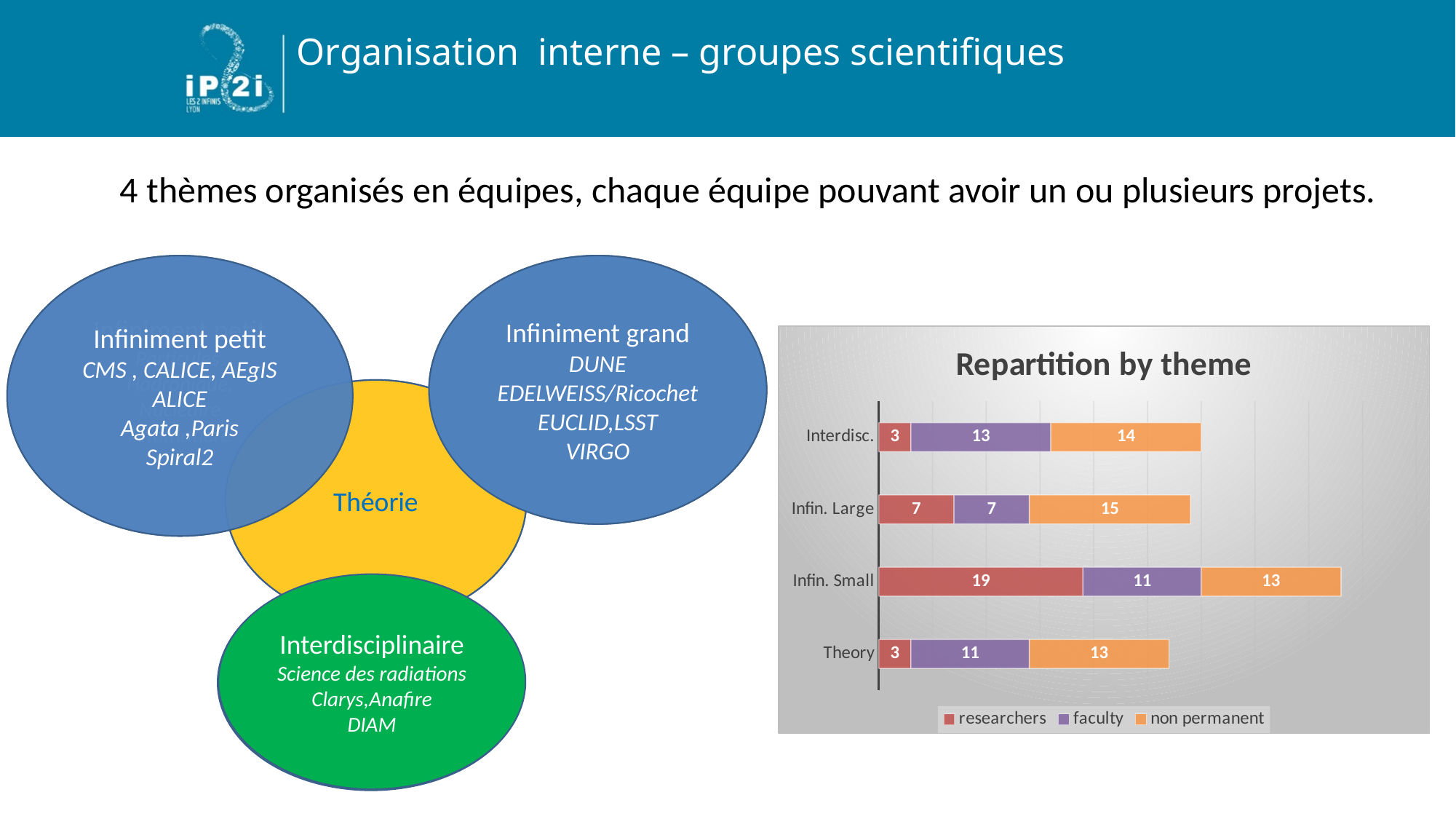
What type of chart is "Repartition by theme"? bar chart In "Repartition by theme", which theme has the lowest number of faculty? Infin. Large In "Repartition by theme", what is the total of the stacked bar for Infin. Small? 43 In "Repartition by theme", which theme has the highest number of researchers? Infin. Small In "Repartition by theme", what is the total of the stacked bar for Theory? 27 In "Repartition by theme", what is the number of non permanent for Infin. Large? 15 How many series does the legend of "Repartition by theme" list? 3 In "Repartition by theme", what is the faculty value for Theory? 11 In "Repartition by theme", what is the difference between the non permanent values for Infin. Large and Infin. Small? 2 How many themes are shown in "Repartition by theme"? 4 In "Repartition by theme", what is the number of researchers for Infin. Small? 19 In "Repartition by theme", which is larger: the faculty value for Interdisc. or the faculty value for Infin. Large? Interdisc.